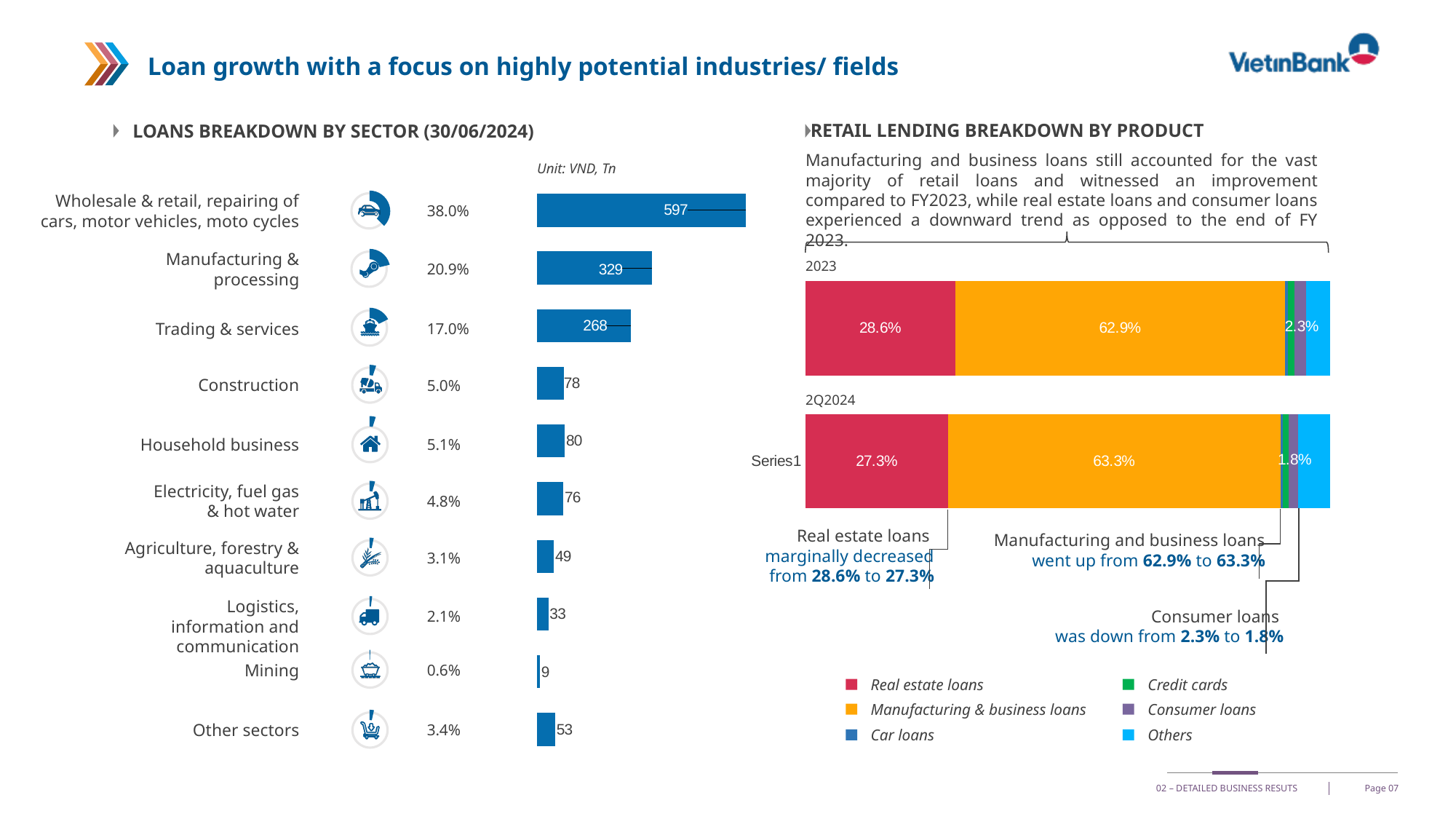
What kind of chart is the Loans breakdown by sector chart? Bar chart In the Loans breakdown by sector chart, what is the value for Mining? 9 In the Loans breakdown by sector chart, which sector has the highest value? Wholesale & retail, repairing of cars, motor vehicles, moto cycles How many sectors are shown in the Loans breakdown by sector chart? 10 In the Retail lending breakdown by product chart, what is the share of Manufacturing & business loans in 2023? 62.9% In the Loans breakdown by sector chart, what is the difference between the values for Wholesale & retail and Manufacturing & processing? 268 In the Retail lending breakdown by product chart, what is the share of Real estate loans in 2Q2024? 27.3% In the Loans breakdown by sector chart, what is the value for Manufacturing & processing? 329 In the Loans breakdown by sector chart, which sector has the lowest value? Mining In the Loans breakdown by sector chart, what percentage share is shown for Trading & services? 17.0% In the Loans breakdown by sector chart, which is larger: Manufacturing & processing or Trading & services? Manufacturing & processing How many entries does the legend of the Retail lending breakdown by product chart list? 6